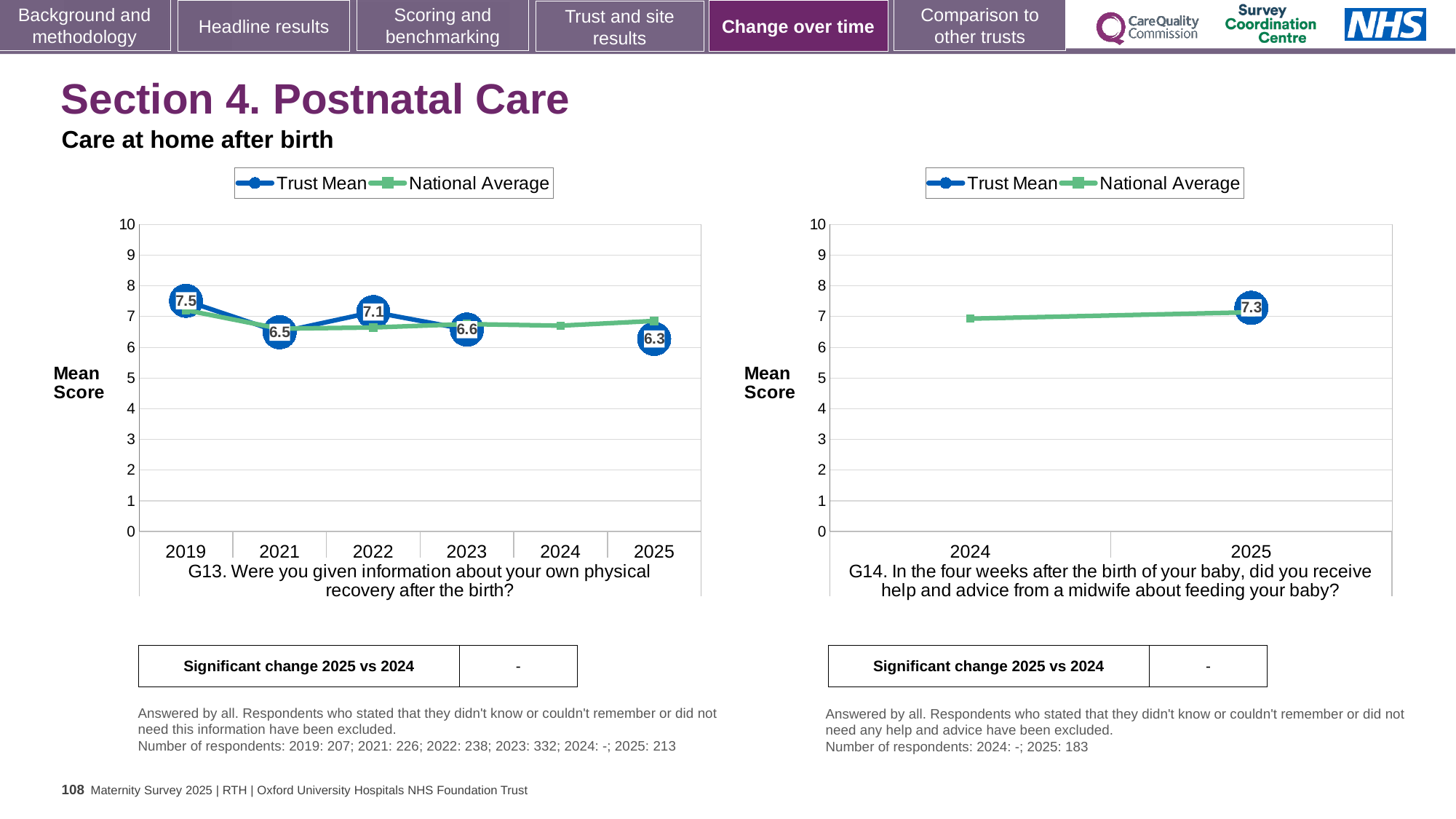
In the G13 chart, which year has the highest labelled Trust Mean score? 2019 How many years are shown on the x axis of the G13 chart? 6 How many series does the legend of the G14 chart list? 2 In the G13 chart, what is the difference between the Trust Mean scores for 2019 and 2025? 1.2 What kind of chart is the G14 chart? Line chart In the G13 chart, what is the Trust Mean score for 2019? 7.5 In the G13 chart, is the National Average value for 2024 greater or less than 7? less In the G14 chart, what is the Trust Mean score for 2025? 7.3 In the G13 chart, which year has the lowest labelled Trust Mean score? 2025 In the G13 chart, which is larger, the Trust Mean score for 2022 or for 2023? 2022 In the G13 chart, what is the Trust Mean score for 2025? 6.3 In the G13 chart, does the Trust Mean score rise or fall overall from 2019 to 2025? Fall